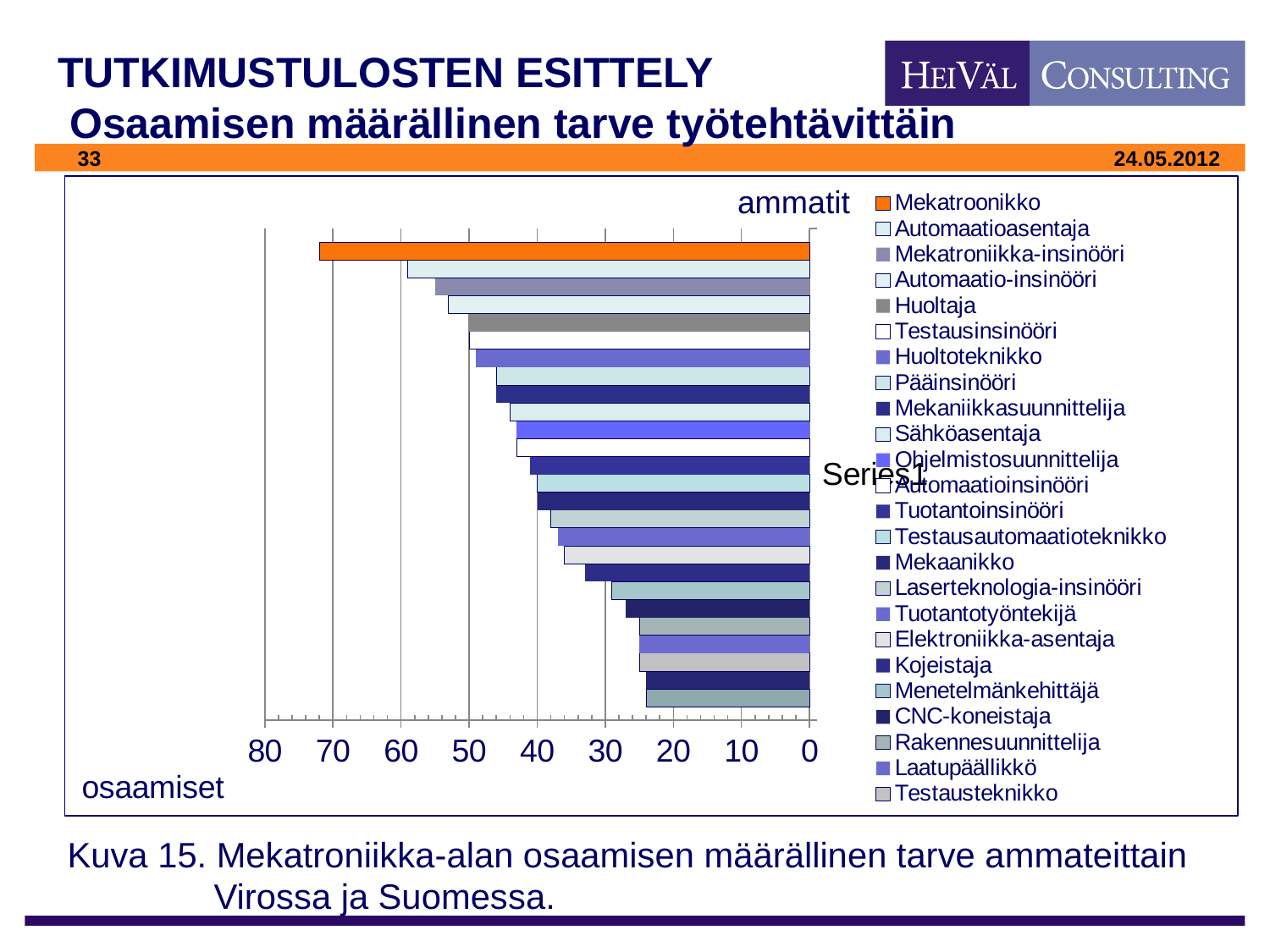
How many categories (professions) does the legend list? 24 Which has a larger value, Elektroniikka-asentaja or Automaatio-insinööri? Automaatio-insinööri Is the value for Mekatroonikko greater or less than 70? greater Which profession has the highest value in the chart? Mekatroonikko Is the value for Kojeistaja greater or less than 40? less What label appears at the bottom left of the chart below the axis? osaamiset Is the value for Huoltaja greater or less than 40? greater What kind of chart is shown on the slide? bar chart Which has a larger value, Mekatroniikka-insinööri or Mekaanikko? Mekatroniikka-insinööri What label is shown at the top of the chart above the legend? ammatit